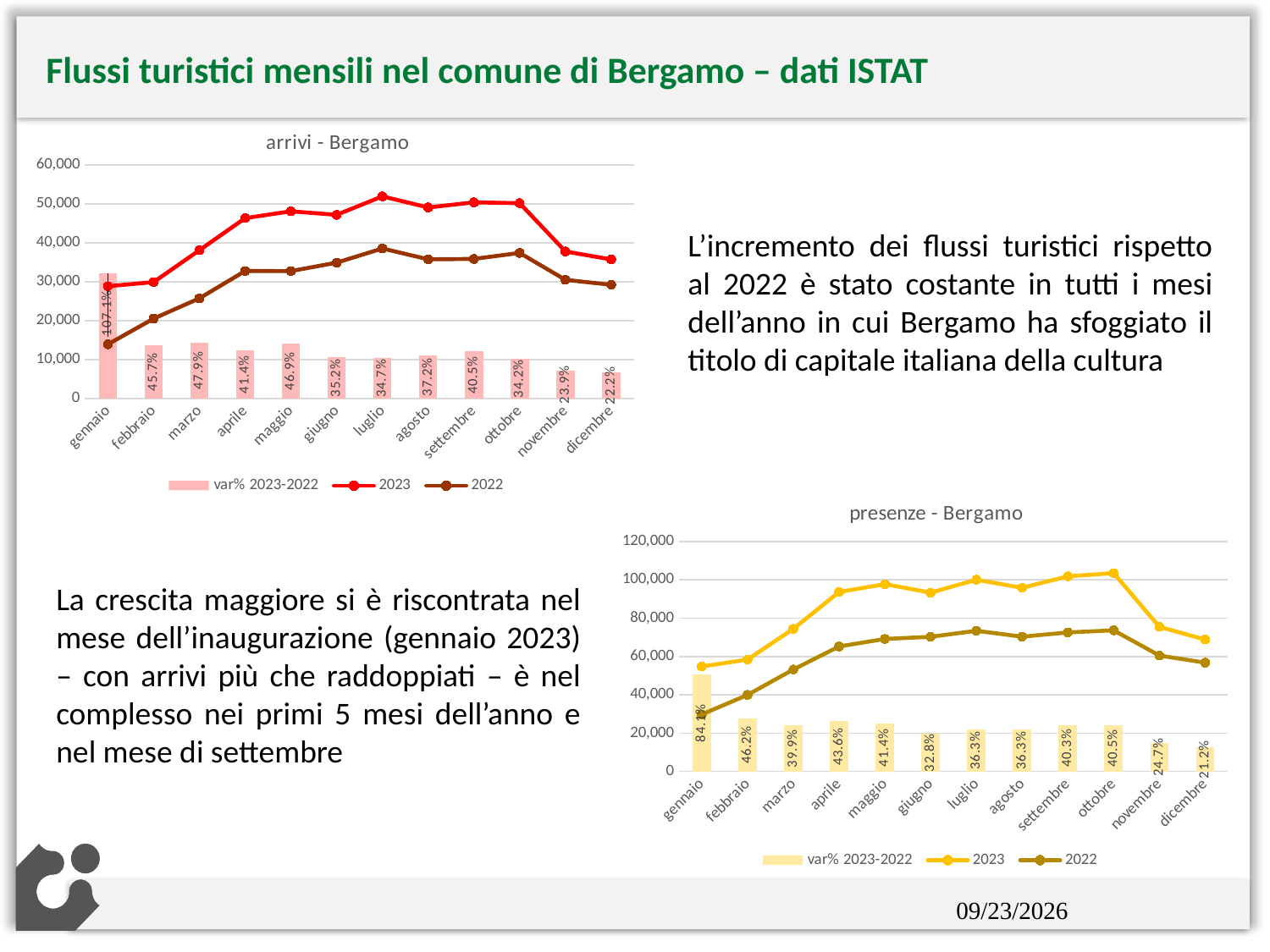
In the 'arrivi - Bergamo' chart, what is the var% 2023-2022 value for gennaio? 107.1% In the 'presenze - Bergamo' chart, how many months are shown on the x axis? 12 What colour is the 2023 line in the 'arrivi - Bergamo' chart? red In the 'arrivi - Bergamo' chart, is the 2023 value for luglio greater or less than 50,000? greater In the 'presenze - Bergamo' chart, does the 2023 line rise or fall from ottobre to dicembre? fall In the 'presenze - Bergamo' chart, which month has the highest var% 2023-2022 value? gennaio In the 'arrivi - Bergamo' chart, which month has the lowest var% 2023-2022 value? dicembre In the 'presenze - Bergamo' chart, which is larger, the var% 2023-2022 value for aprile or for marzo? aprile In the 'arrivi - Bergamo' chart, what is the difference between the var% 2023-2022 values for marzo and febbraio? 2.2% In the 'presenze - Bergamo' chart, is the 2022 value for gennaio greater or less than 40,000? less In the 'arrivi - Bergamo' chart, how many series does the legend list? 3 In the 'presenze - Bergamo' chart, what is the var% 2023-2022 value for ottobre? 40.5%